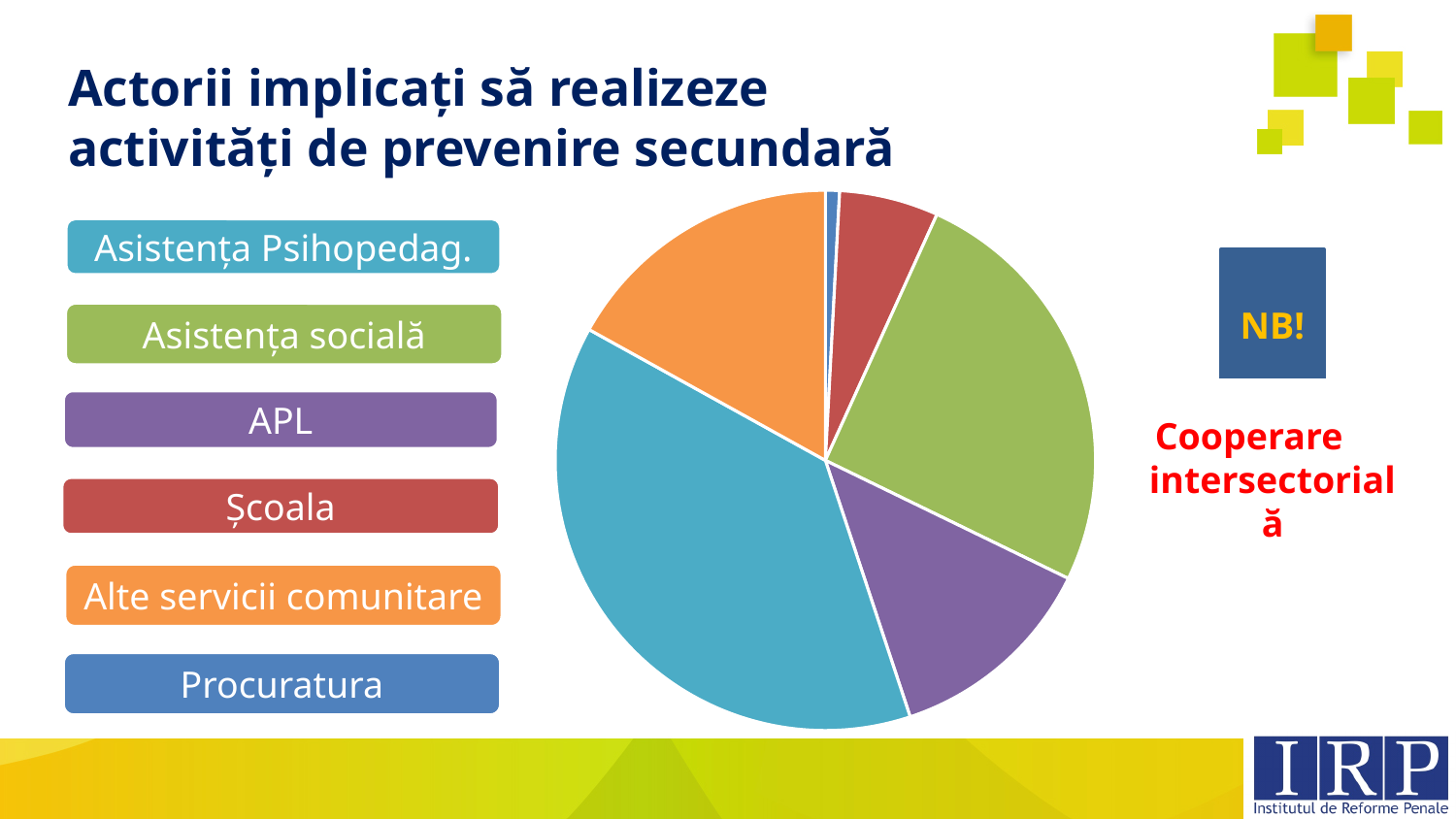
What kind of chart is shown on the slide? pie chart Which slice is larger, APL or Școala? APL How many categories (slices) does the pie chart have? 6 Which slice is larger, Asistența Psihopedag. or Asistența socială? Asistența Psihopedag. Which category has the smallest slice of the pie chart? Procuratura What is the title of the slide containing the pie chart? Actorii implicați să realizeze activități de prevenire secundară Which category has the largest slice of the pie chart? Asistența Psihopedag. Which slice is larger, Procuratura or Școala? Școala Which colour represents APL in the pie chart? purple